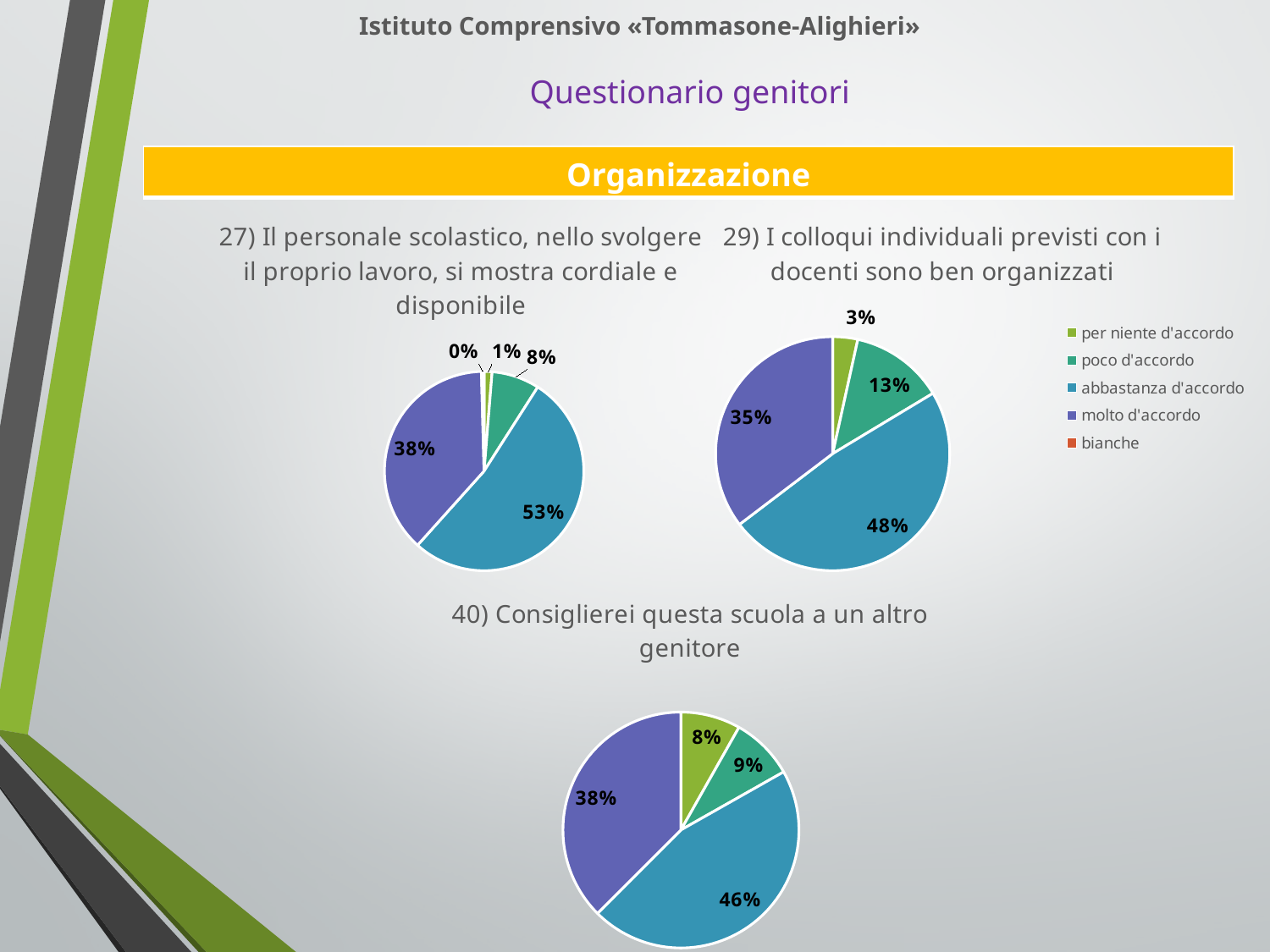
What type of chart is used for question 40? Pie chart In the chart for question 40, which response category has the largest share? abbastanza d'accordo In the chart for question 40 (consiglierei questa scuola), what share is 'abbastanza d'accordo'? 46% In the chart for question 29, what share is 'per niente d'accordo'? 3% In the chart for question 29, what is the difference between the 'abbastanza d'accordo' and 'molto d'accordo' shares? 13% How many response categories does the legend list? 5 In the chart for question 40, which is larger: 'molto d'accordo' or 'poco d'accordo'? molto d'accordo In the chart for question 29, which response category has the largest share? abbastanza d'accordo In the chart for question 29 (colloqui individuali ben organizzati), what share is 'poco d'accordo'? 13% In the chart for question 40, what share is 'per niente d'accordo'? 8% In the chart for question 27, what share is 'molto d'accordo'? 38% In the chart for question 27 (personale scolastico cordiale e disponibile), what share is 'abbastanza d'accordo'? 53%